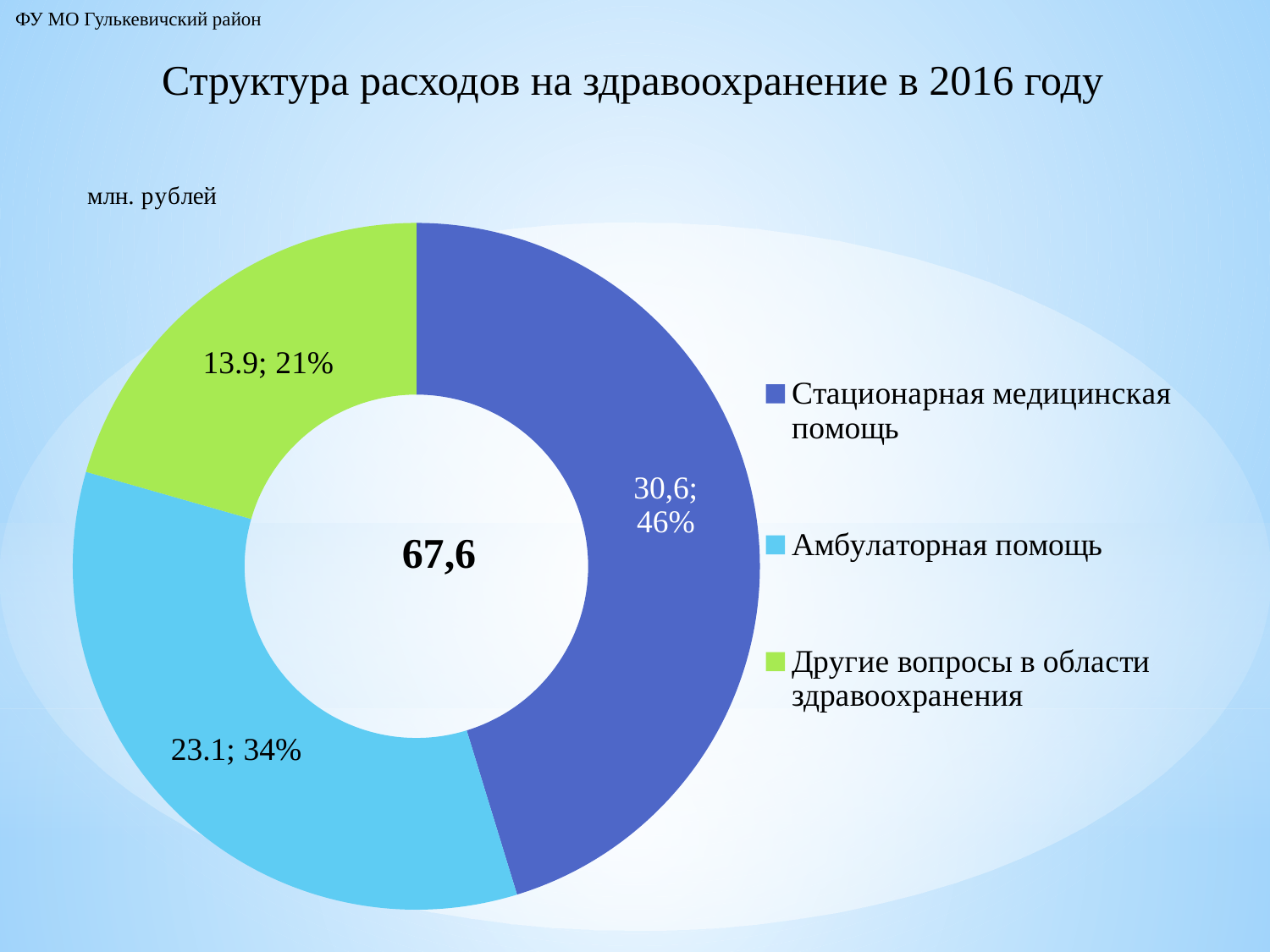
What share of the chart does Амбулаторная помощь represent? 34% Which category has the largest slice? Стационарная медицинская помощь What is the value shown for Стационарная медицинская помощь? 30,6 What is the value shown for Амбулаторная помощь? 23.1 How many categories does the chart show? 3 What is the value shown for Другие вопросы в области здравоохранения? 13.9 Which is larger, Амбулаторная помощь or Другие вопросы в области здравоохранения? Амбулаторная помощь Which category has the smallest slice? Другие вопросы в области здравоохранения What type of chart is shown on the slide? doughnut (pie) chart What total value is shown in the centre of the chart? 67,6 What share of the chart does Стационарная медицинская помощь represent? 46% What share of the chart does Другие вопросы в области здравоохранения represent? 21%